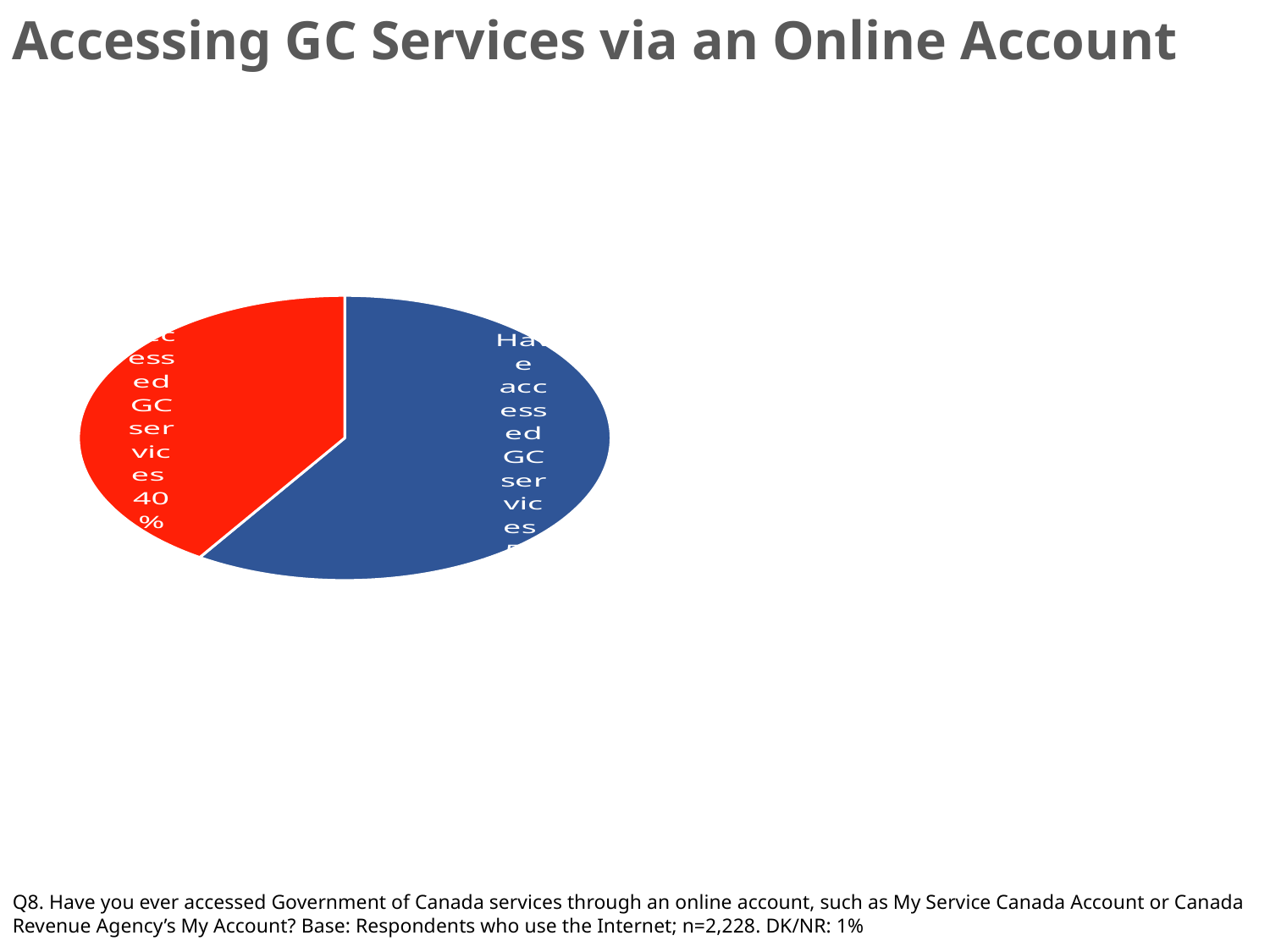
Which slice of the pie chart is the largest? the blue slice (Have accessed GC services) How many slices does the pie chart have? 2 Which slice of the pie chart is the smallest? the red slice (40%) Which slice of the pie chart is larger, the red slice or the blue slice? the blue slice What colour is the slice labelled 'Have accessed GC services'? blue Is the share of the blue 'Have accessed GC services' slice greater or less than 50%? greater What kind of chart is shown on the slide? pie chart What is the title of the slide containing the pie chart? Accessing GC Services via an Online Account Is the share of the red slice greater or less than 50%? less What percentage is shown on the red slice of the pie chart? 40%